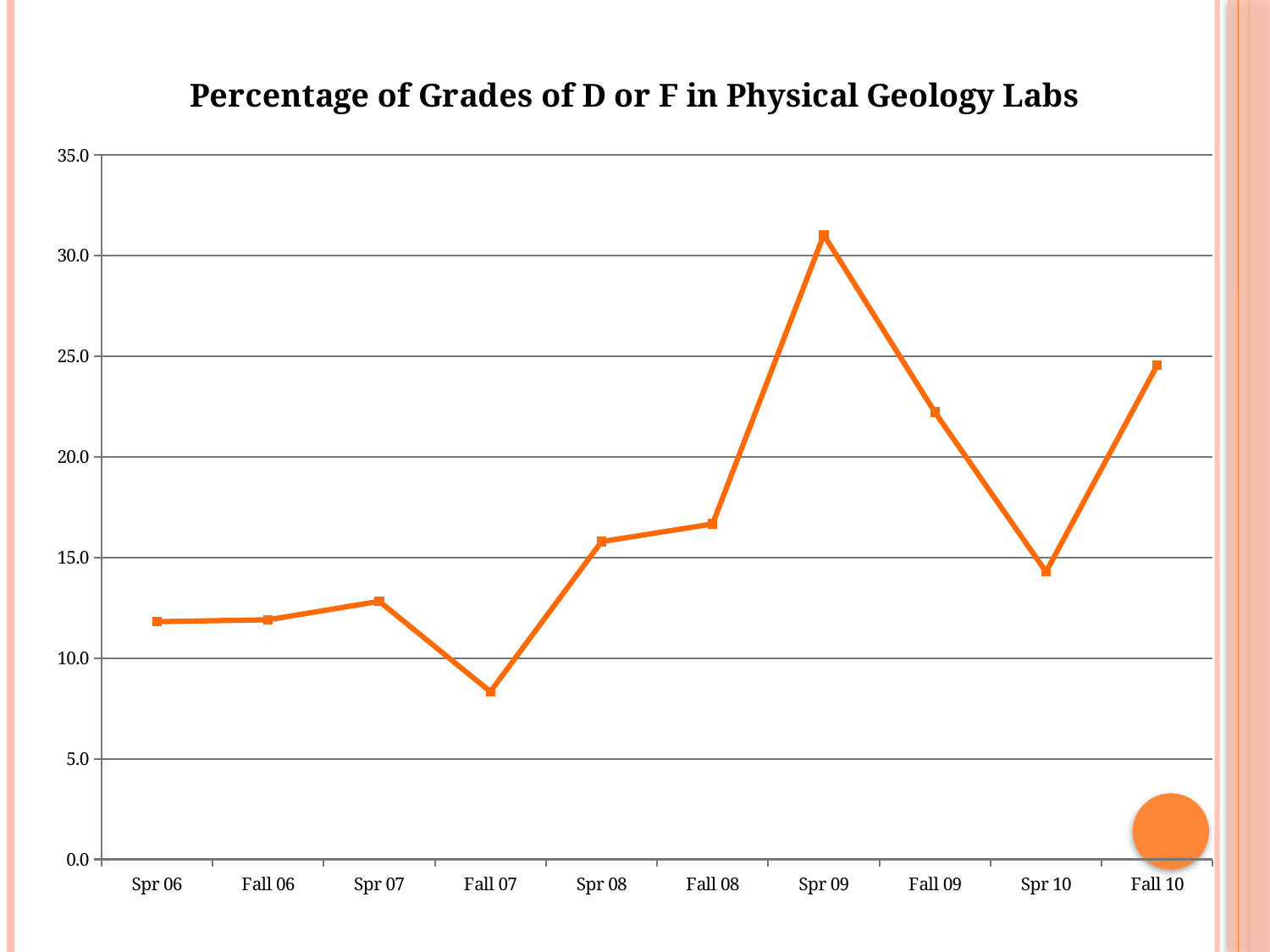
Is the value for Spr 10 greater or less than 15.0? less Is the value for Fall 09 greater or less than 20.0? greater What is the title of the chart? Percentage of Grades of D or F in Physical Geology Labs What kind of chart is shown on the slide? line chart Which semester has the lowest percentage of D or F grades? Fall 07 Is the value for Spr 09 greater or less than 30.0? greater Does the line rise or fall from Spr 09 to Spr 10? fall How many semesters are plotted along the x axis? 10 Which is larger, the value for Fall 10 or the value for Fall 09? Fall 10 Which is larger, the value for Spr 07 or the value for Spr 10? Spr 10 Which semester has the highest percentage of D or F grades? Spr 09